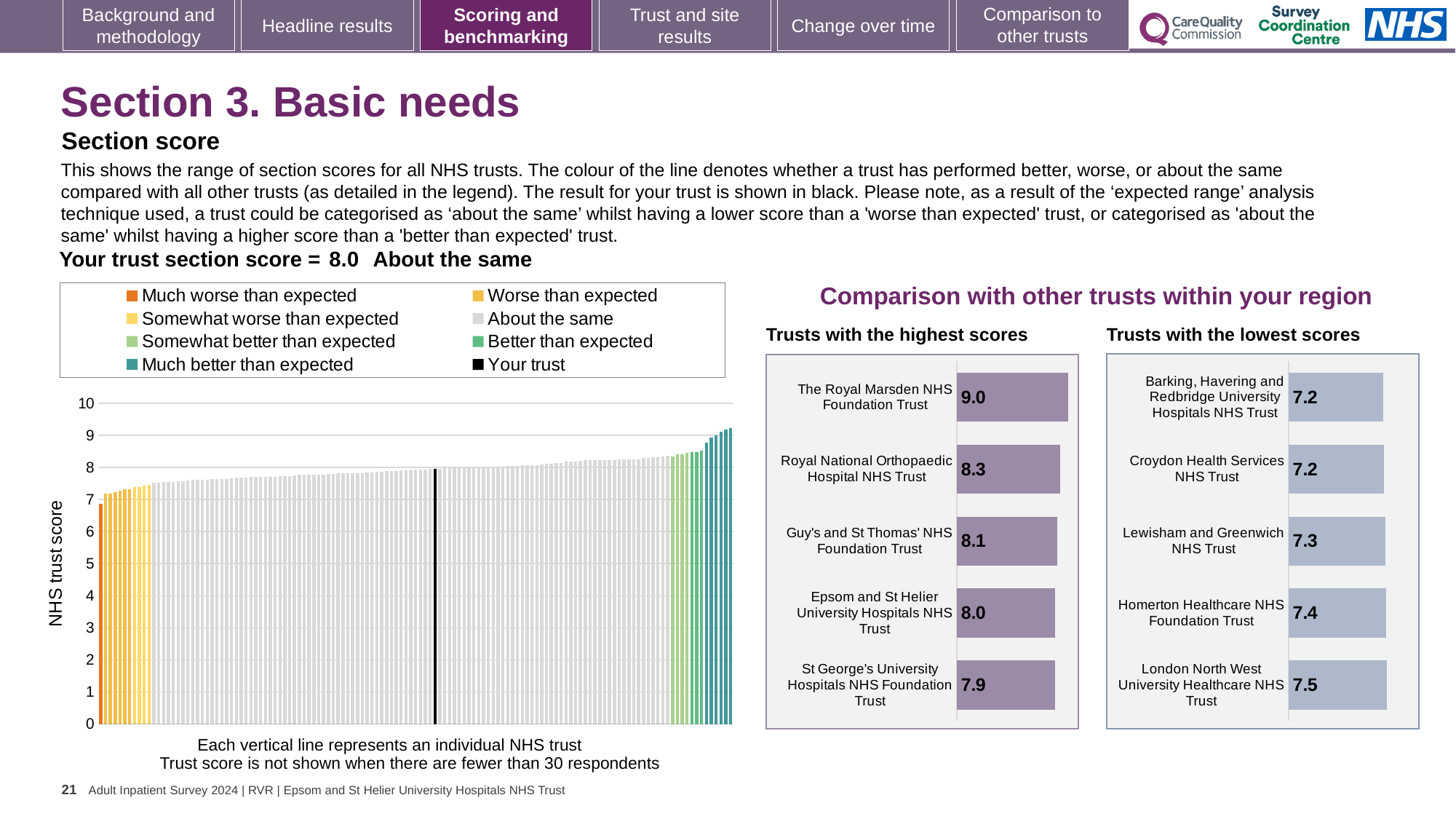
In the 'Trusts with the highest scores' chart, what is the score for Epsom and St Helier University Hospitals NHS Trust? 8.0 In the 'Trusts with the lowest scores' chart, which trust has the highest score? London North West University Healthcare NHS Trust How many entries does the legend of the main section score chart on the left list? 8 In the main section score chart on the left, do the trust scores rise or fall from left to right along the x axis? Rise In the 'Trusts with the lowest scores' chart, what is the score for Lewisham and Greenwich NHS Trust? 7.3 In the 'Trusts with the highest scores' chart, which trust has the lowest score? St George's University Hospitals NHS Foundation Trust In the 'Trusts with the lowest scores' chart, which has the larger score: Homerton Healthcare NHS Foundation Trust or London North West University Healthcare NHS Trust? London North West University Healthcare NHS Trust In the 'Trusts with the highest scores' chart, what is the difference between the scores of The Royal Marsden NHS Foundation Trust and St George's University Hospitals NHS Foundation Trust? 1.1 In the 'Trusts with the highest scores' chart, which trust has the highest score? The Royal Marsden NHS Foundation Trust In the 'Trusts with the highest scores' chart, what is the score for The Royal Marsden NHS Foundation Trust? 9.0 How many trusts are shown in the 'Trusts with the highest scores' chart? 5 What kind of chart is the 'Trusts with the lowest scores' chart? Bar chart